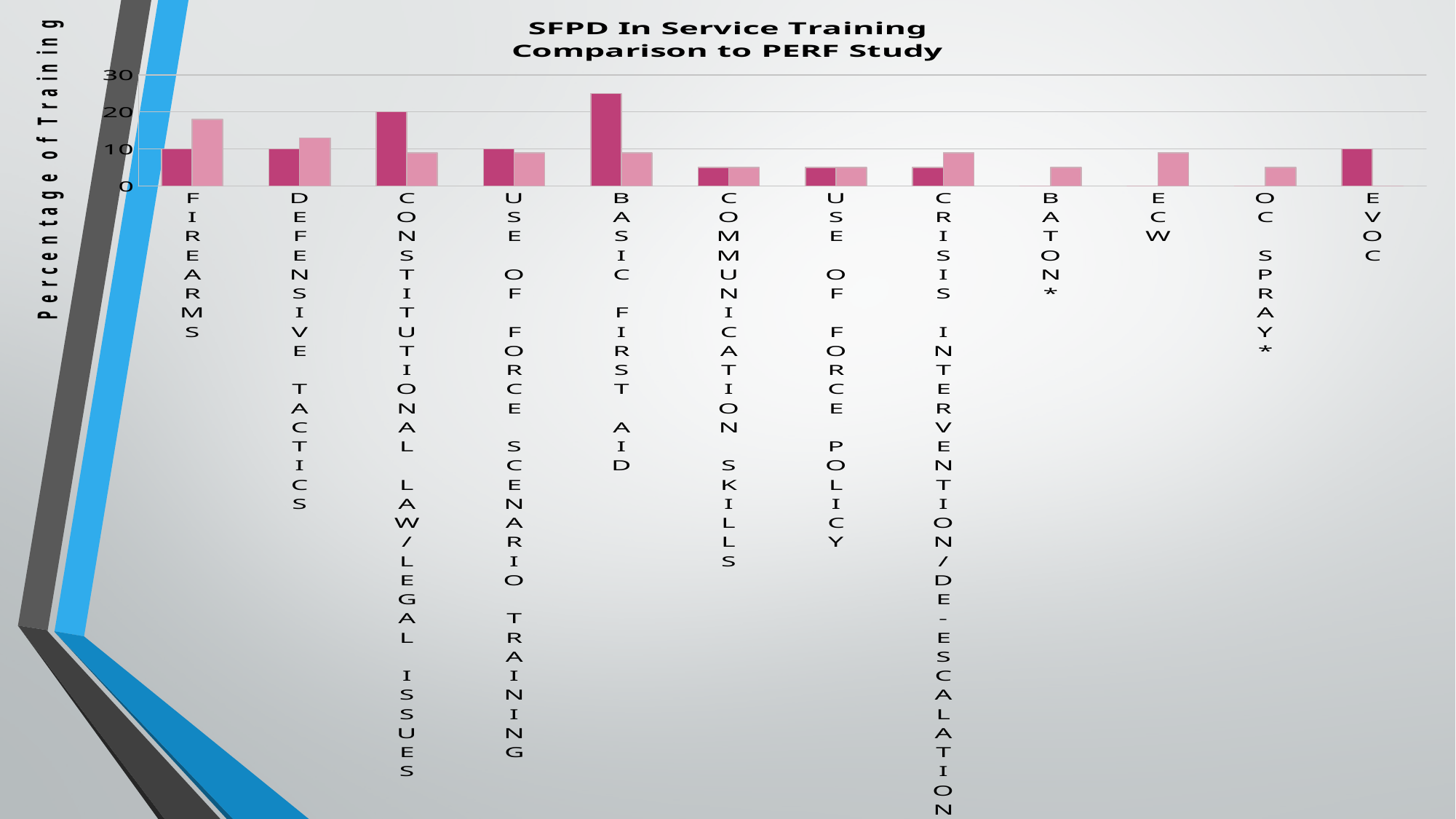
What is the label on the vertical axis of the chart? Percentage of Training Are the bars for Communication Skills greater or less than 10? less What value does the darker pink bar for EVOC reach on the axis? 10 Is the tallest bar for Basic First Aid greater or less than 20? greater What type of chart is shown on the slide? bar chart What is the title of the chart? SFPD In Service Training Comparison to PERF Study Is the lighter pink bar for Firearms greater or less than 10? greater What value does the darker pink bar for Constitutional Law/Legal Issues reach on the axis? 20 Which category has the tallest bar in the chart? Basic First Aid How many training categories are shown along the x axis? 12 Which is taller: the darker pink bar for Basic First Aid or the darker pink bar for Firearms? Basic First Aid